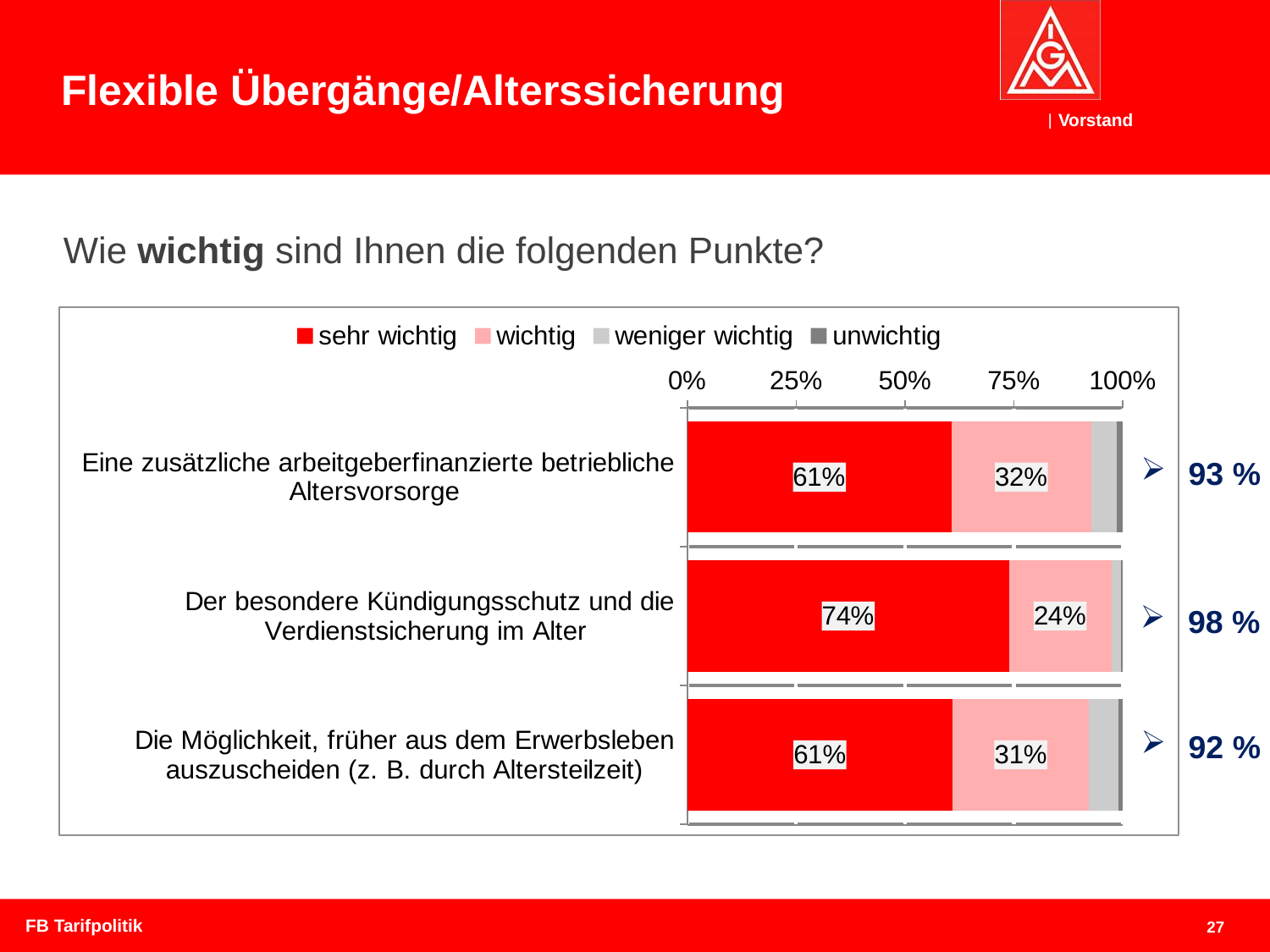
How many series does the legend list? 4 What is the 'wichtig' value for 'Eine zusätzliche arbeitgeberfinanzierte betriebliche Altersvorsorge'? 32% What is the 'wichtig' value for 'Die Möglichkeit, früher aus dem Erwerbsleben auszuscheiden (z. B. durch Altersteilzeit)'? 31% What is the 'sehr wichtig' value for 'Der besondere Kündigungsschutz und die Verdienstsicherung im Alter'? 74% Which category has the lowest 'wichtig' value? Der besondere Kündigungsschutz und die Verdienstsicherung im Alter How many categories are plotted in the chart? 3 Is the 'sehr wichtig' value for 'Die Möglichkeit, früher aus dem Erwerbsleben auszuscheiden (z. B. durch Altersteilzeit)' greater or less than 50%? greater Which legend entry is shown in the darkest grey colour? unwichtig What kind of chart is shown on the slide? stacked bar chart Which category has the highest 'sehr wichtig' value? Der besondere Kündigungsschutz und die Verdienstsicherung im Alter What is the difference between the 'sehr wichtig' values for 'Der besondere Kündigungsschutz und die Verdienstsicherung im Alter' and 'Eine zusätzliche arbeitgeberfinanzierte betriebliche Altersvorsorge'? 13% What is the combined 'sehr wichtig' and 'wichtig' total shown next to the bar for 'Der besondere Kündigungsschutz und die Verdienstsicherung im Alter'? 98 %